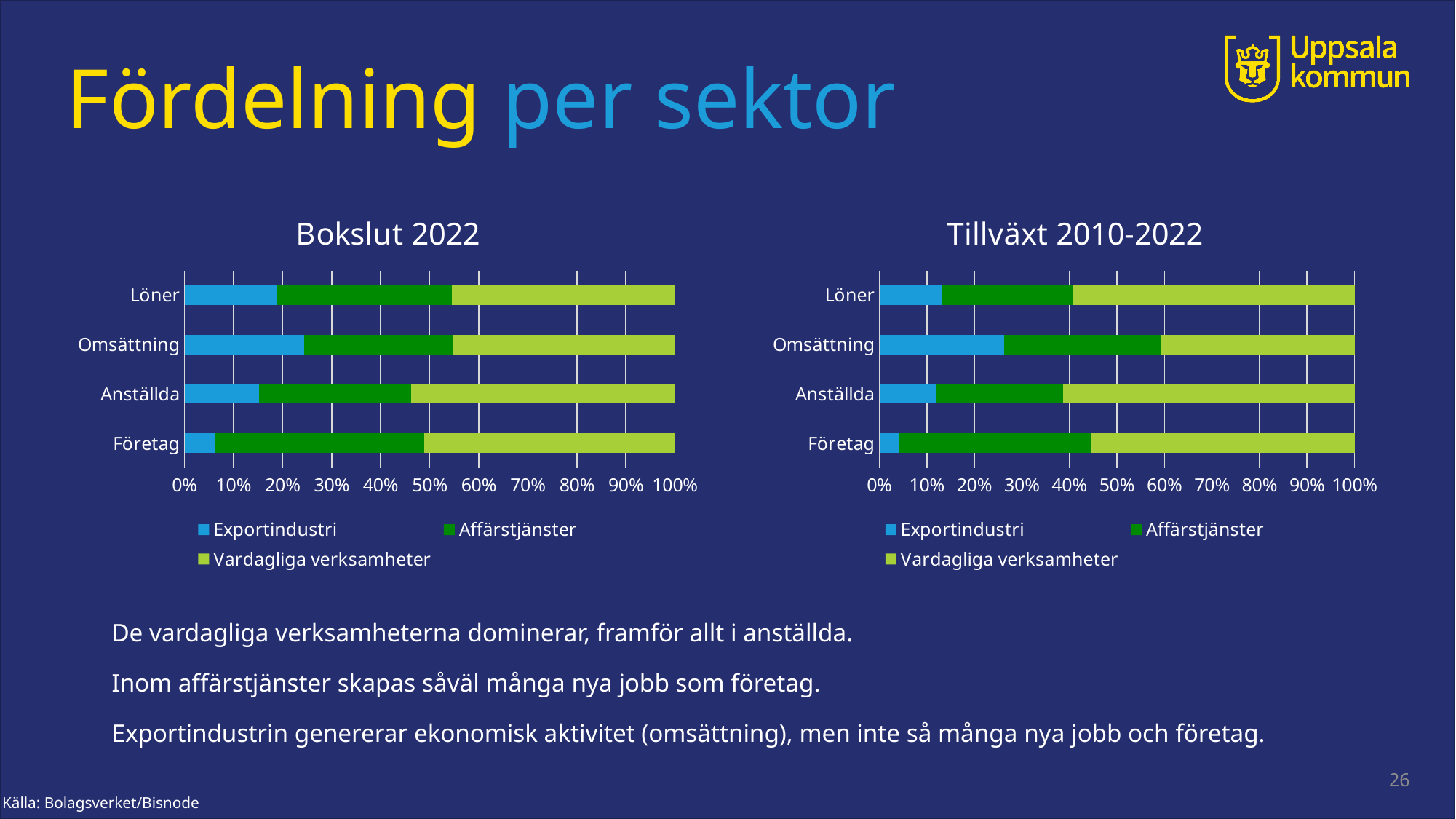
In the 'Tillväxt 2010-2022' chart, is the Exportindustri share for Omsättning greater or less than 20%? greater In the 'Bokslut 2022' chart, is the Exportindustri share for Företag greater or less than 10%? less What are the titles of the two charts on the slide? Bokslut 2022 and Tillväxt 2010-2022 In the 'Bokslut 2022' chart, is the Exportindustri share for Omsättning greater or less than 20%? greater In the 'Bokslut 2022' chart, which category has the smallest Exportindustri share? Företag In the 'Bokslut 2022' chart, which category has the largest Exportindustri share? Omsättning How many series does the legend of the 'Bokslut 2022' chart list? 3 What kind of chart is the 'Bokslut 2022' chart? Stacked bar chart In the 'Tillväxt 2010-2022' chart, which category has the largest Exportindustri share? Omsättning How many categories are shown on the 'Tillväxt 2010-2022' chart? 4 In the 'Tillväxt 2010-2022' chart, is the Exportindustri share larger for Löner or for Företag? Löner